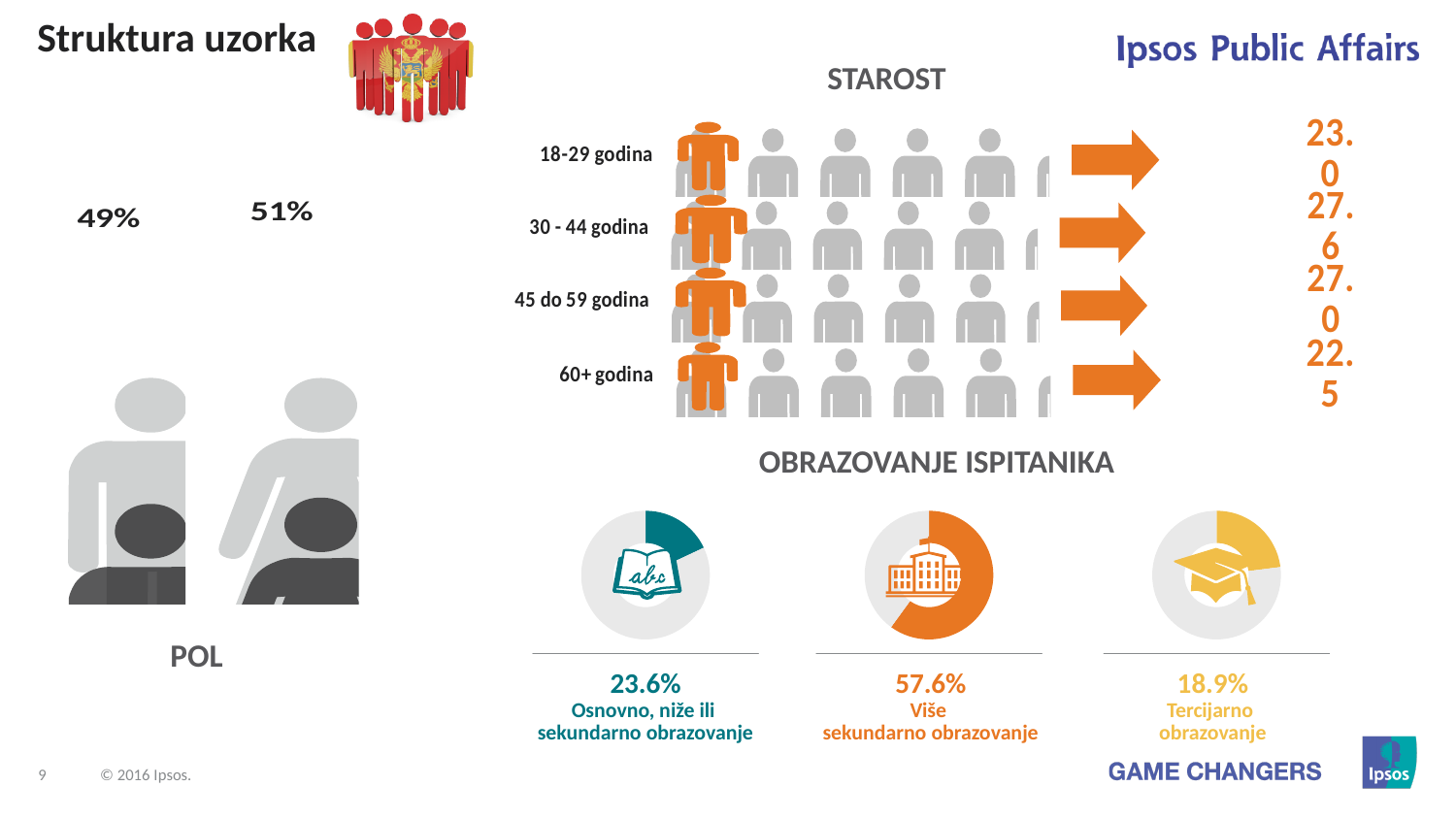
In the OBRAZOVANJE ISPITANIKA chart, which education category has the largest share? Više sekundarno obrazovanje In the POL chart, what are the two percentages shown? 49% and 51% In the STAROST chart, what is the difference between the values for 30 - 44 godina and 60+ godina? 5.1 In the OBRAZOVANJE ISPITANIKA chart, which is larger: Osnovno, niže ili sekundarno obrazovanje or Tercijarno obrazovanje? Osnovno, niže ili sekundarno obrazovanje In the STAROST chart, which age group has the lowest value? 60+ godina In the STAROST chart, what is the value for the 60+ godina group? 22.5 In the STAROST chart, what is the value for the 18-29 godina group? 23.0 In the STAROST chart, how many age groups are shown? 4 In the STAROST chart, which age group has the highest value? 30 - 44 godina In the STAROST chart, what is the value for the 30 - 44 godina group? 27.6 In the OBRAZOVANJE ISPITANIKA chart, what is the share for Tercijarno obrazovanje? 18.9% In the OBRAZOVANJE ISPITANIKA chart, what is the share for Više sekundarno obrazovanje? 57.6%